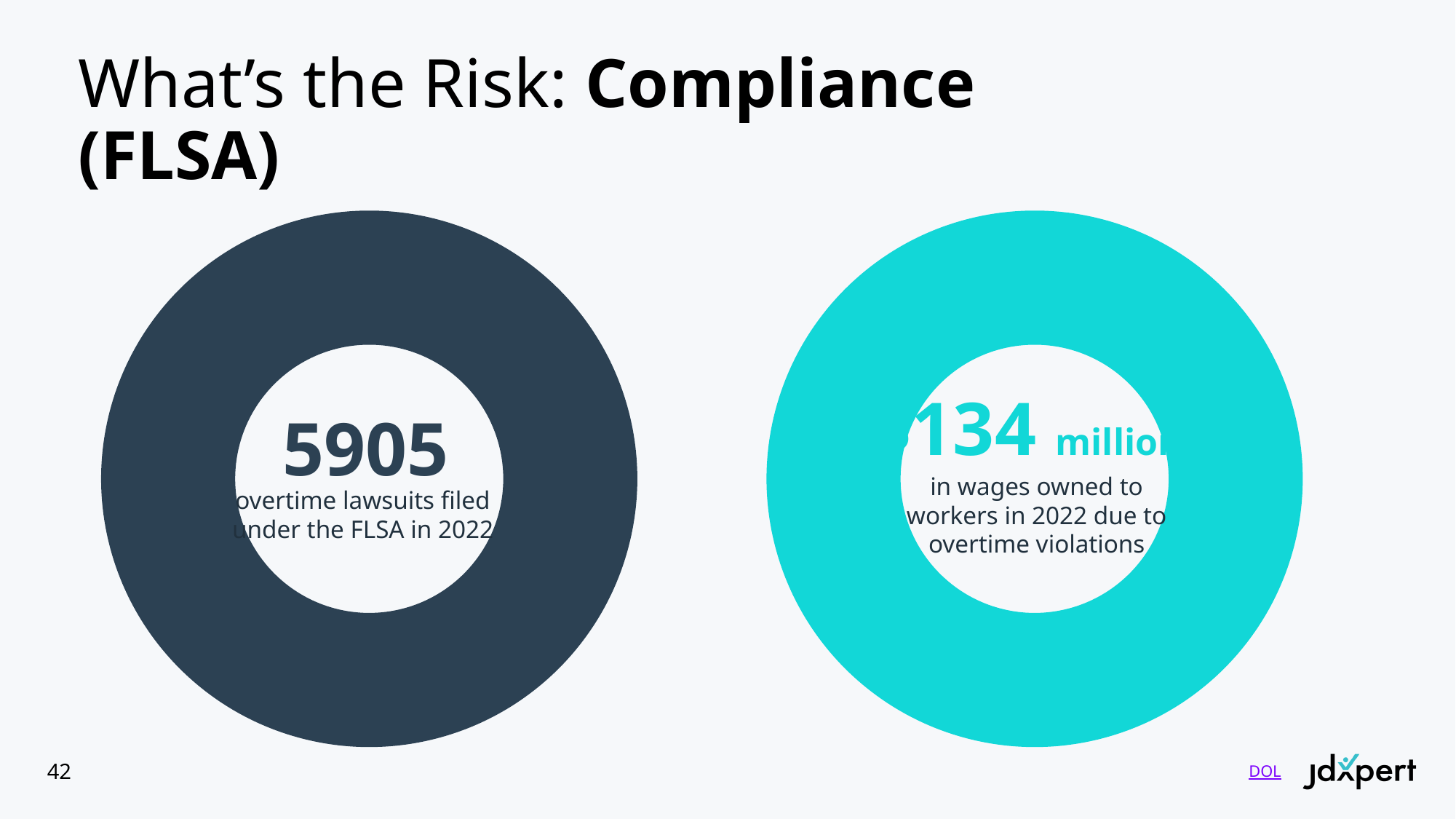
What colour is the ring of the left-hand doughnut chart? dark navy blue How many doughnut charts are on the slide? 2 What kind of chart is shown on the right side of the slide? doughnut chart How many segments does the left-hand doughnut chart's ring contain? 1 What value is printed in the centre of the left-hand doughnut chart? 5905 What does the text inside the right-hand doughnut chart say the 134 million figure represents? in wages owned to workers in 2022 due to overtime violations What kind of chart is shown on the left side of the slide? doughnut chart What colour is the ring of the right-hand doughnut chart? turquoise According to the left-hand doughnut chart, how many overtime lawsuits were filed under the FLSA in 2022? 5905 What number is printed in the centre of the right-hand doughnut chart? 134 Which year do both doughnut charts refer to? 2022 What share of the right-hand doughnut ring does its single segment occupy? 100%